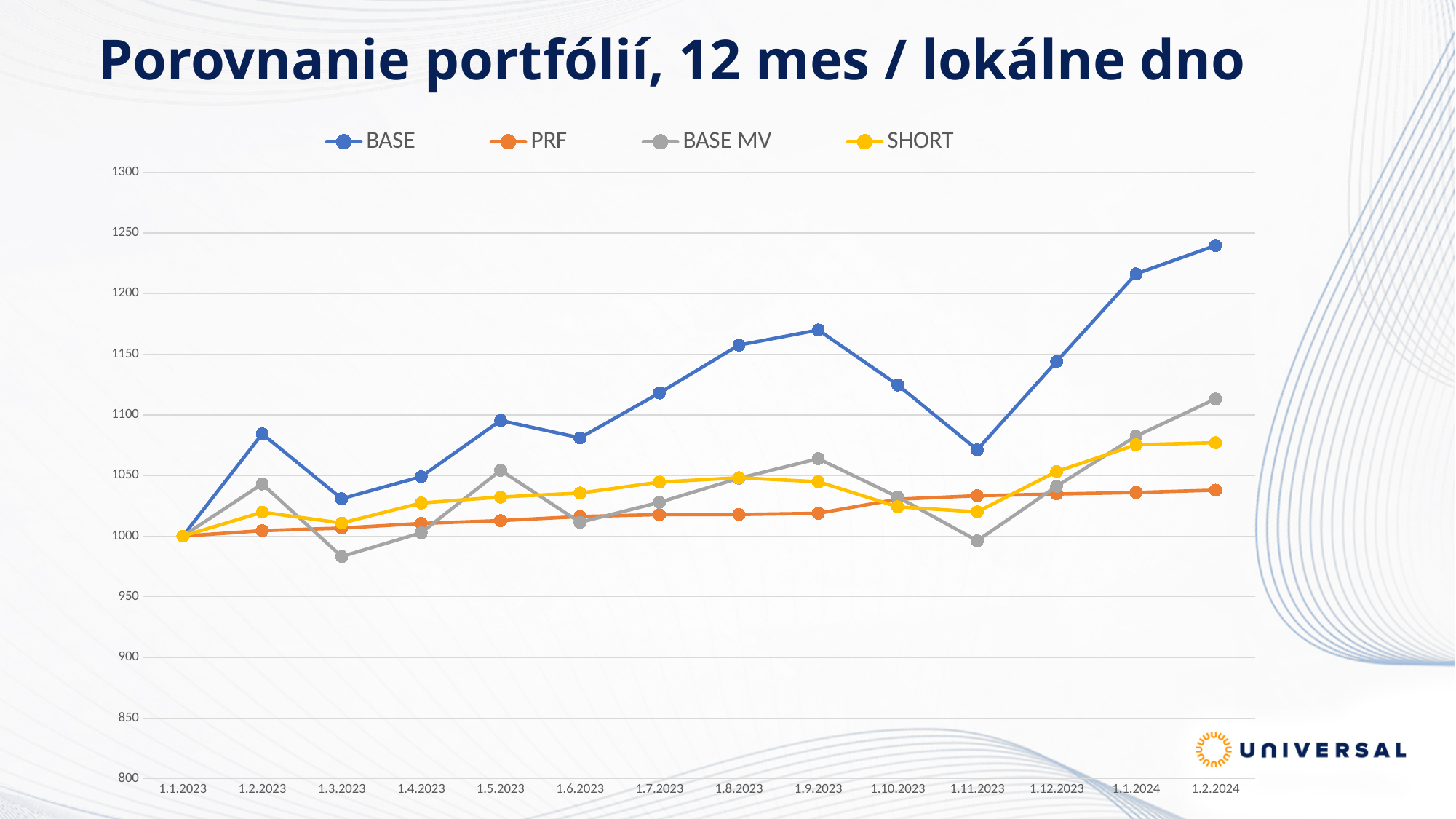
Is the value for BASE MV at 1.3.2023 greater or less than 1000? less Is the value for PRF at 1.2.2024 greater or less than 1050? less Which series has the lowest value at 1.3.2023? BASE MV At 1.9.2023, which is larger: BASE or BASE MV? BASE How many series does the legend list? 4 Does the BASE series rise or fall from 1.11.2023 to 1.2.2024? rise Is the value for BASE at 1.2.2024 greater or less than 1200? greater What is the value of the BASE series at 1.1.2023? 1000 Which series has the lowest value at 1.2.2024? PRF How many dates are shown on the x axis? 14 Which series has the highest value at 1.2.2024? BASE What kind of chart is shown on the slide? line chart